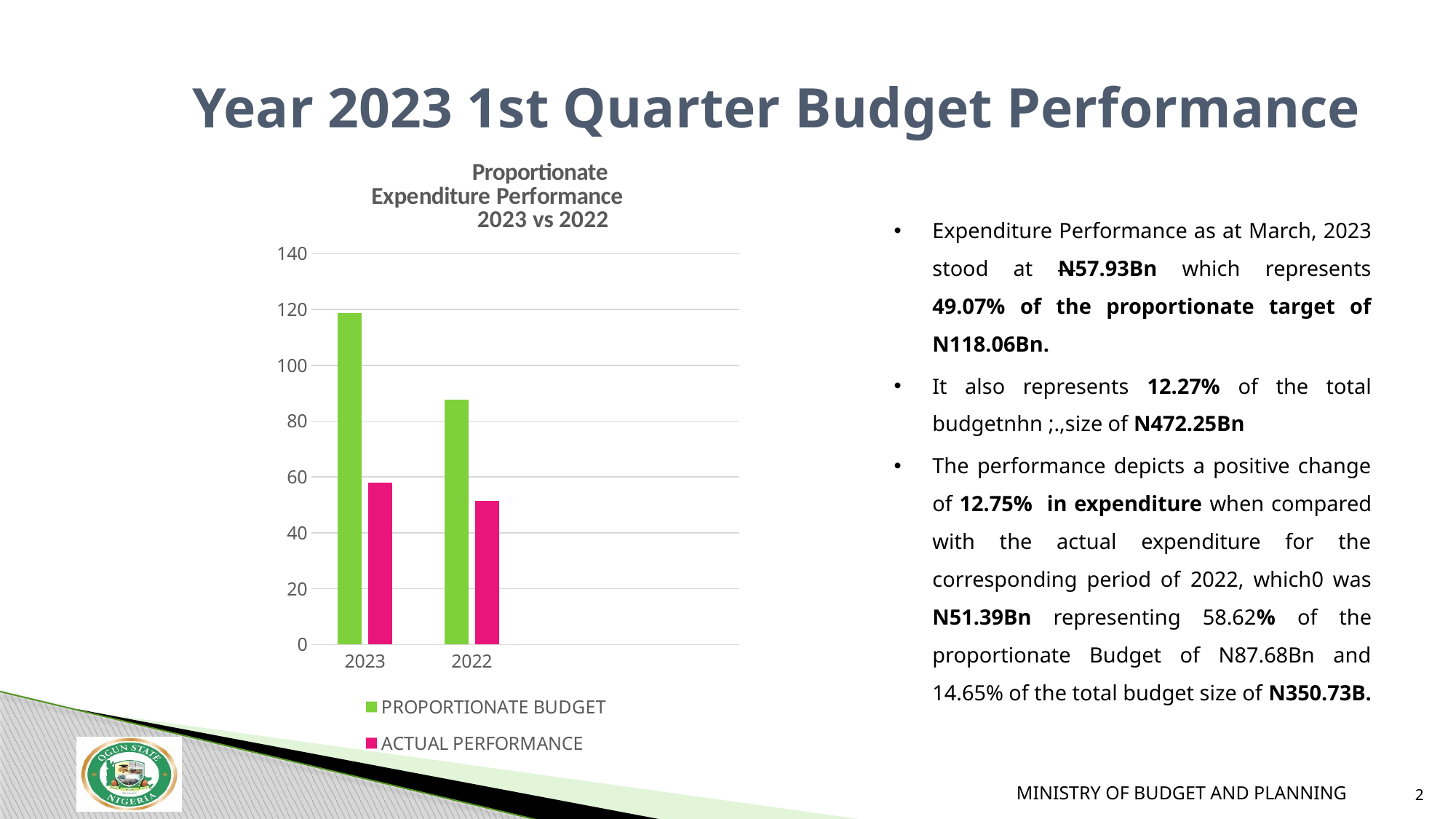
How many series does the legend list? 2 Which category has the lowest ACTUAL PERFORMANCE bar? 2022 Is the PROPORTIONATE BUDGET value for 2023 greater or less than 100? greater How many categories are shown on the x axis? 2 Is the PROPORTIONATE BUDGET value for 2022 greater or less than 80? greater Which category has the highest PROPORTIONATE BUDGET bar? 2023 What colour are the ACTUAL PERFORMANCE bars? pink What type of chart is shown on the slide? bar chart Which is larger, the PROPORTIONATE BUDGET for 2022 or the ACTUAL PERFORMANCE for 2023? PROPORTIONATE BUDGET for 2022 What is the title of the chart? Proportionate Expenditure Performance 2023 vs 2022 Is the ACTUAL PERFORMANCE value for 2022 greater or less than 60? less